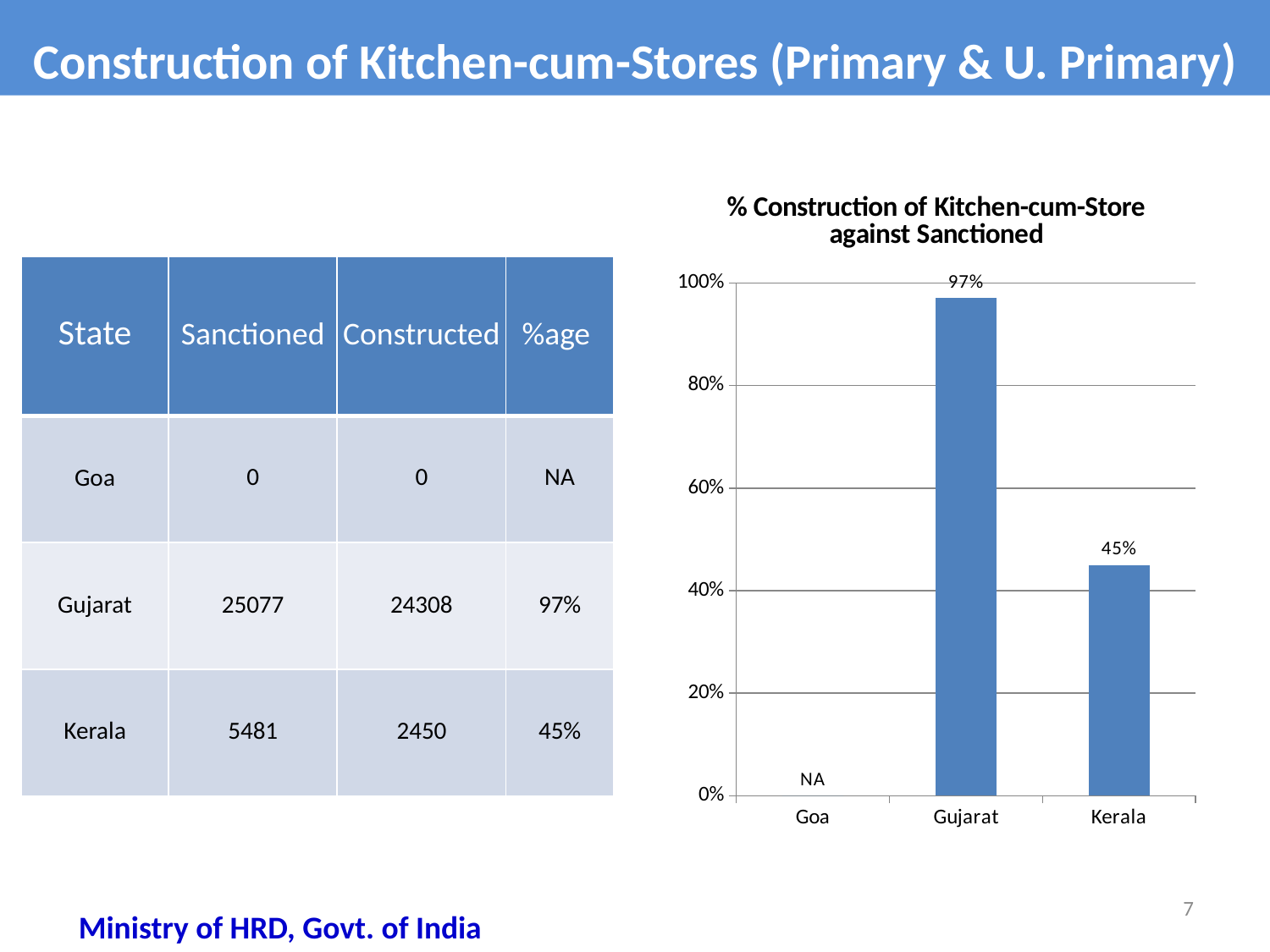
Which is larger, the value for Gujarat or the value for Kerala? Gujarat What is the difference between the values for Gujarat and Kerala? 52% What label is shown for Goa in the chart? NA What is the value for Kerala in the chart? 45% What kind of chart is shown on the slide? bar chart Is the value for Gujarat greater or less than 80%? greater How many states are shown on the x axis of the chart? 3 What is the title of the chart? % Construction of Kitchen-cum-Store against Sanctioned What is the highest value shown on the y axis of the chart? 100% Is the value for Kerala greater or less than 60%? less What is the value for Gujarat in the chart? 97% Which state has the highest bar in the chart? Gujarat